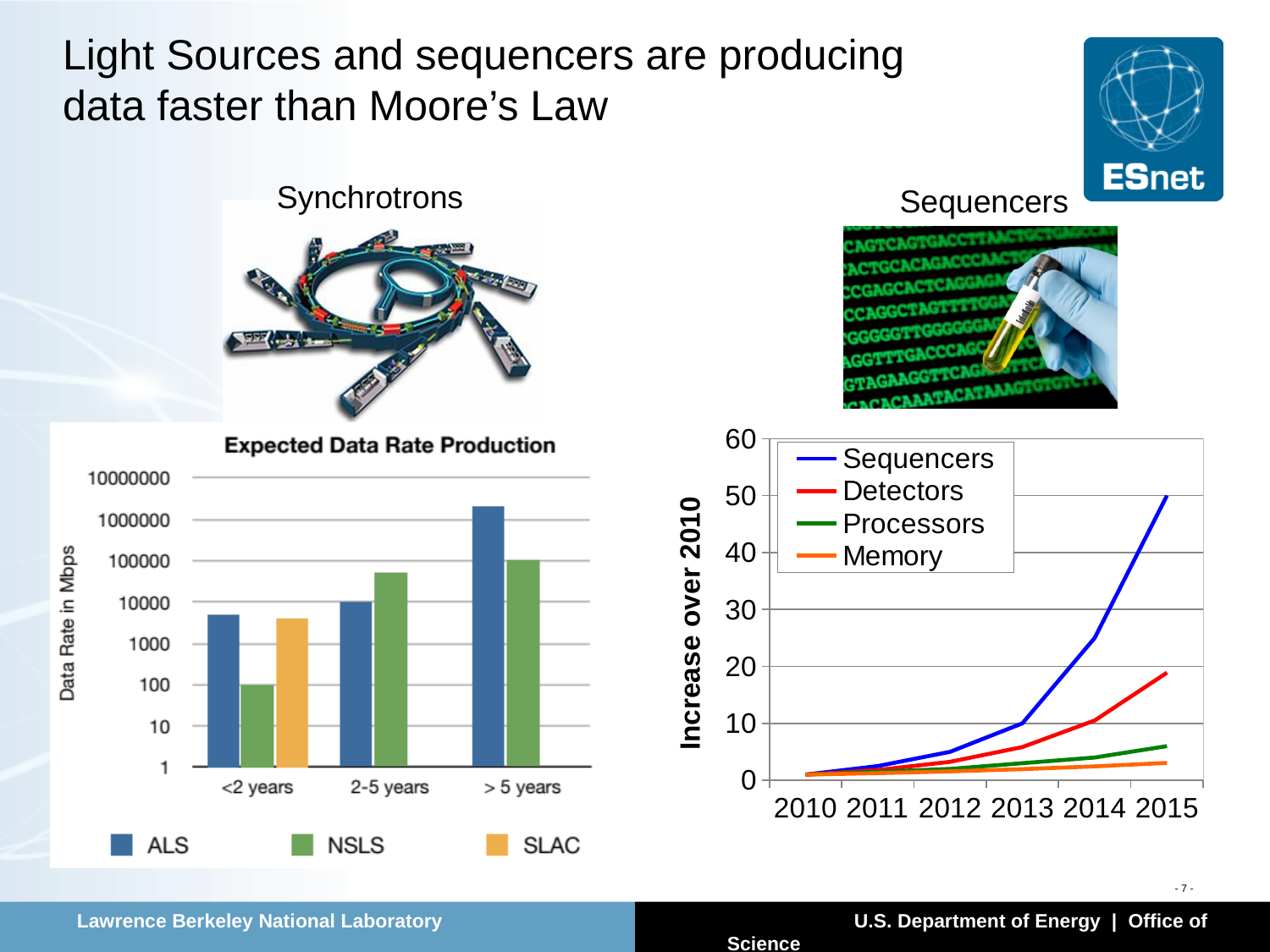
In the chart on the right, does the Sequencers line rise or fall from 2010 to 2015? rise In the chart on the right, is the value for Sequencers in 2015 greater or less than 40? greater In the chart on the right, how many series does the legend list? 4 In the chart on the right, is the value for Detectors in 2015 greater or less than 20? less In the 'Expected Data Rate Production' chart, how many categories are shown on the x axis? 3 In the 'Expected Data Rate Production' chart, how many series does the legend list? 3 In the chart on the right, which series has the lowest value in 2015? Memory In the 'Expected Data Rate Production' chart, which is larger in the '> 5 years' category, ALS or NSLS? ALS What kind of chart is the 'Expected Data Rate Production' chart on the left? bar chart In the chart on the right, how many years are shown on the x axis? 6 In the chart on the right, which series has the highest value in 2015? Sequencers What kind of chart is the chart on the right with the 'Increase over 2010' axis? line chart